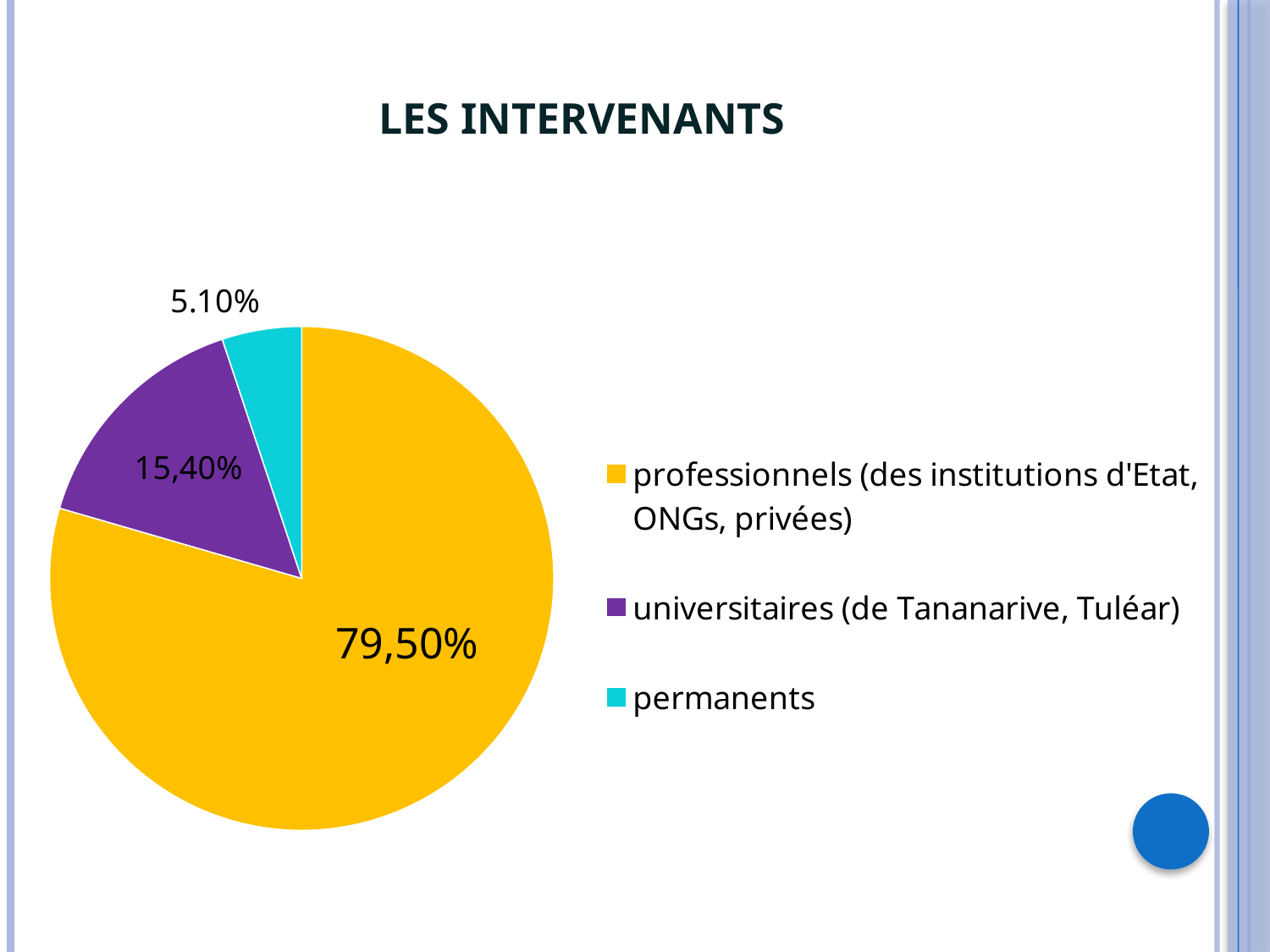
Which category has the smallest slice of the pie? permanents What is the difference in percentage points between the universitaires slice and the permanents slice? 10,30 What share of the pie is labelled for permanents? 5.10% What is the difference in percentage points between the professionnels slice and the universitaires slice? 64,10 What is the title of the slide containing the chart? LES INTERVENANTS Which category has the largest slice of the pie? professionnels (des institutions d'Etat, ONGs, privées) What share of the pie is labelled for universitaires (de Tananarive, Tuléar)? 15,40% How many slices does the pie chart have? 3 Which slice is larger: universitaires (de Tananarive, Tuléar) or permanents? universitaires (de Tananarive, Tuléar) What share of the pie is labelled for professionnels (des institutions d'Etat, ONGs, privées)? 79,50% What colour is the slice for permanents? cyan What kind of chart is shown on the slide? pie chart